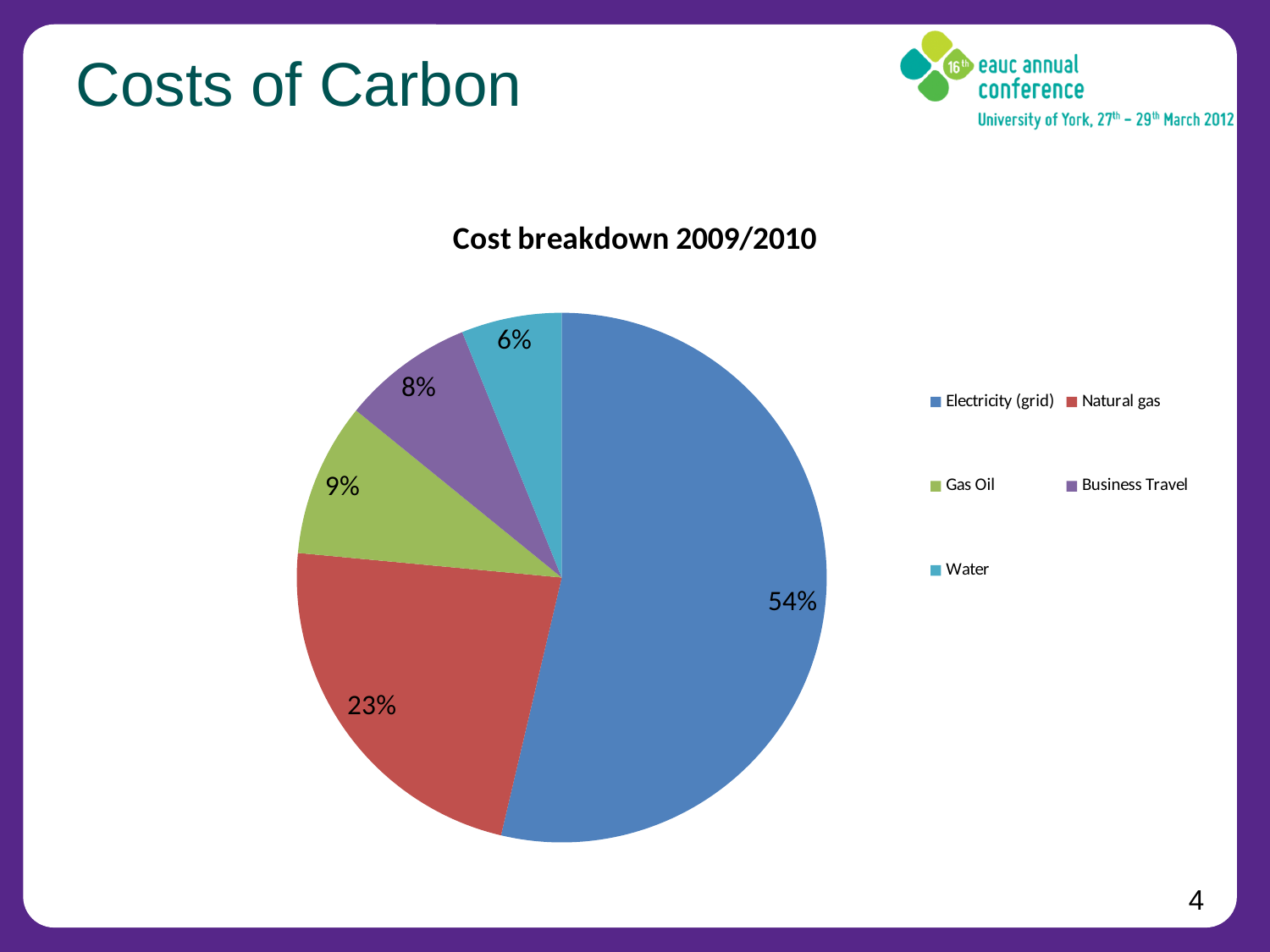
Which has a larger share, Gas Oil or Business Travel? Gas Oil What share of the cost breakdown is Natural gas? 23% What share of the cost breakdown is Gas Oil? 9% What type of chart is shown on the slide? pie chart Which category has the largest share of the cost breakdown? Electricity (grid) What is the difference in percentage points between the Electricity (grid) share and the Natural gas share? 31 What share of the cost breakdown is Business Travel? 8% How many categories does the pie chart show? 5 Which category has the smallest share of the cost breakdown? Water What is the title of the chart? Cost breakdown 2009/2010